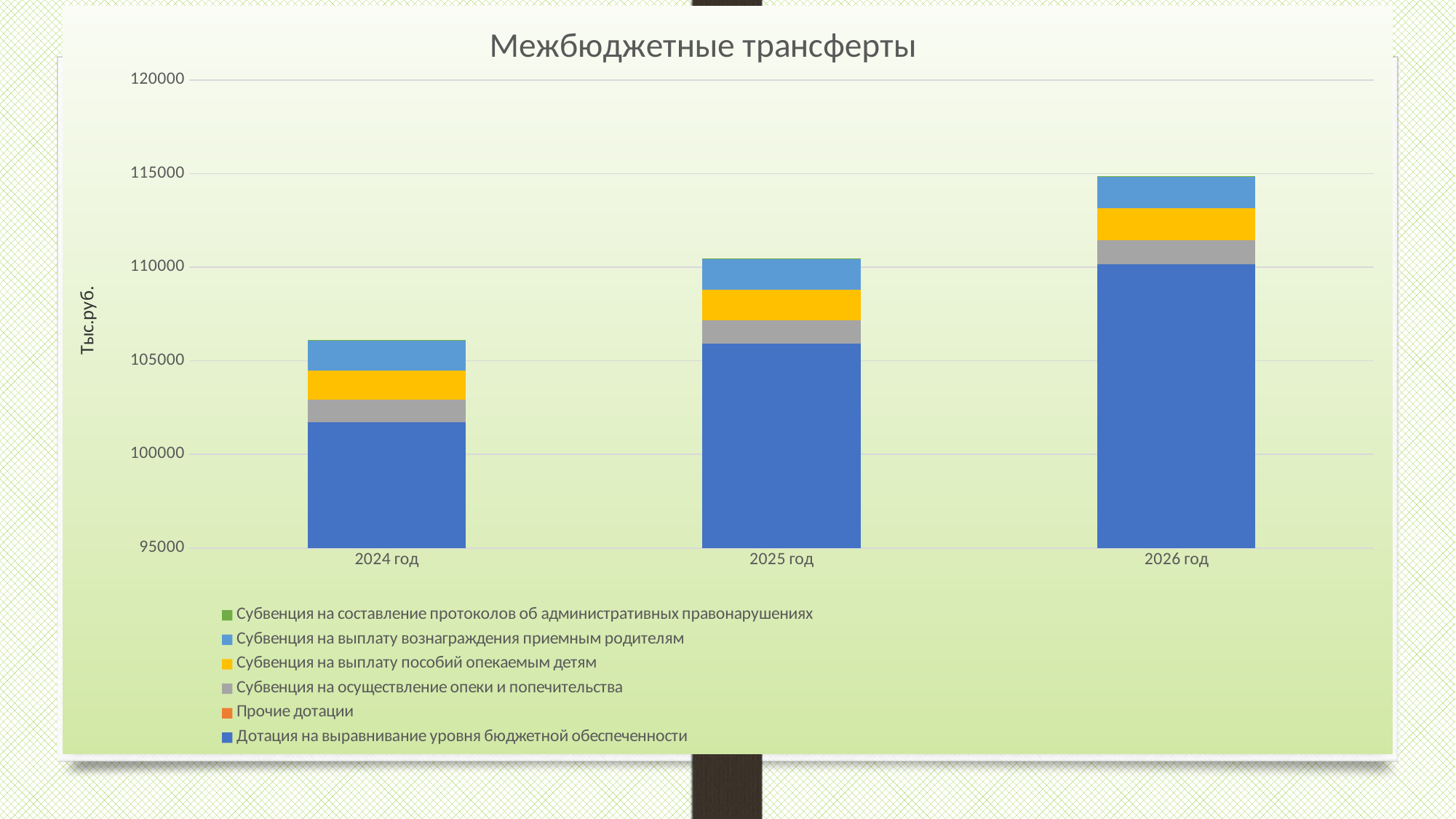
How many series does the legend list? 6 Which year has the shortest stacked bar? 2024 год How many years (categories) are shown on the x axis? 3 What is the title of the chart? Межбюджетные трансферты Is the total bar height for 2024 год greater or less than 110000? less Which series is shown in dark blue at the bottom of each bar? Дотация на выравнивание уровня бюджетной обеспеченности Do the total bar heights rise or fall from 2024 год to 2026 год? rise Which is larger, the total bar for 2026 год or the total bar for 2024 год? 2026 год What kind of chart is shown on the slide? stacked bar chart Is the total bar height for 2025 год greater or less than 105000? greater Which year has the tallest stacked bar? 2026 год Is the total bar height for 2026 год greater or less than 110000? greater